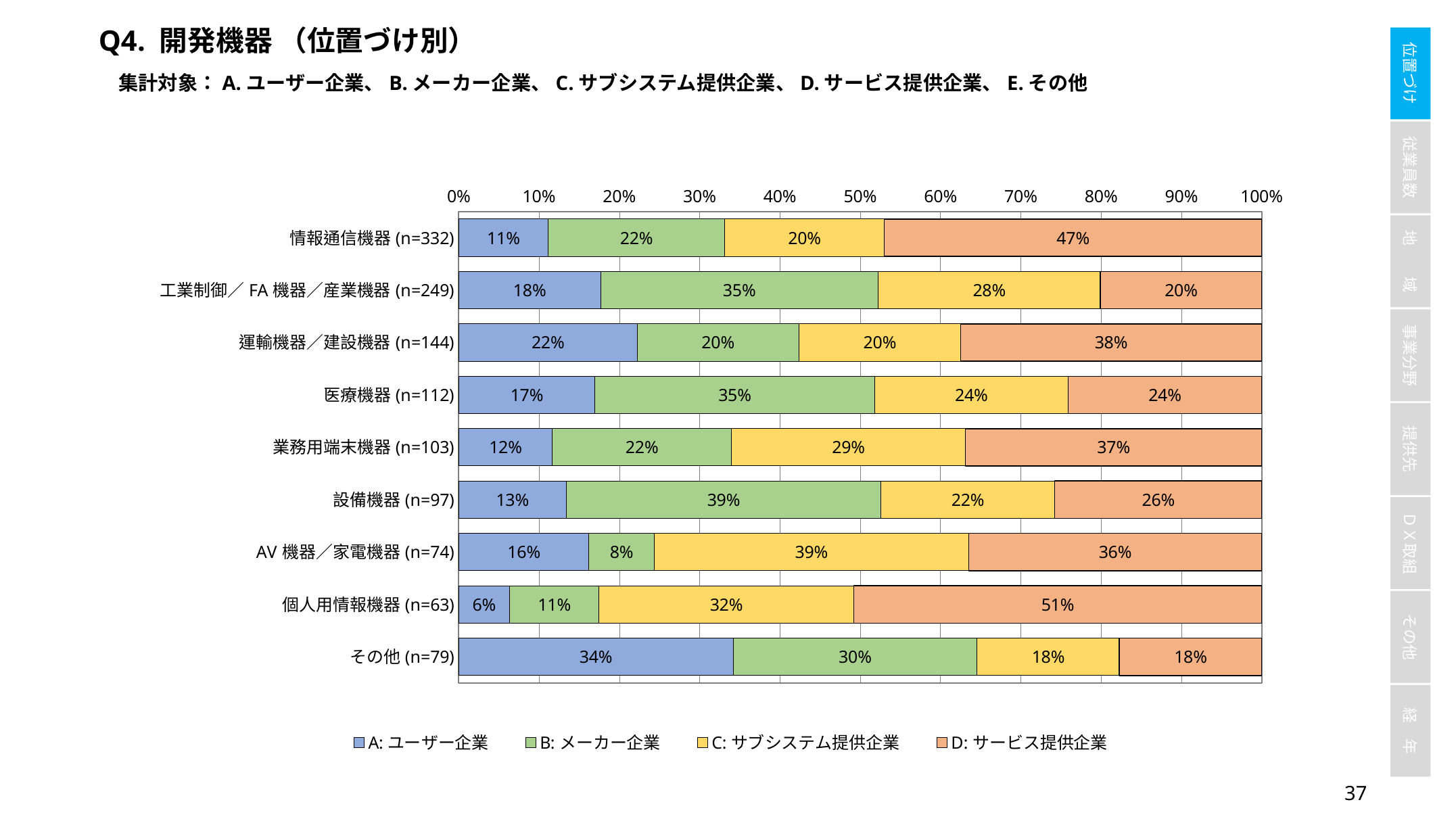
What colour represents C: サブシステム提供企業 in the chart? Yellow Which is larger: the B: メーカー企業 value for 医療機器 (n=112) or for 運輸機器／建設機器 (n=144)? 医療機器 (n=112) What is the value for A: ユーザー企業 in the その他 (n=79) bar? 34% What kind of chart is shown on the slide? Stacked bar chart What is the difference between the C: サブシステム提供企業 value for AV 機器／家電機器 (n=74) and for その他 (n=79)? 21% What is the total of the stacked bar for 工業制御／ FA 機器／産業機器 (n=249)? 101% How many device categories are plotted on the chart? 9 Which category has the highest value for D: サービス提供企業? 個人用情報機器 (n=63) What is the value for D: サービス提供企業 in the 情報通信機器 (n=332) bar? 47% Which category has the lowest value for A: ユーザー企業? 個人用情報機器 (n=63) What is the value for B: メーカー企業 in the 設備機器 (n=97) bar? 39% How many series does the legend list? 4